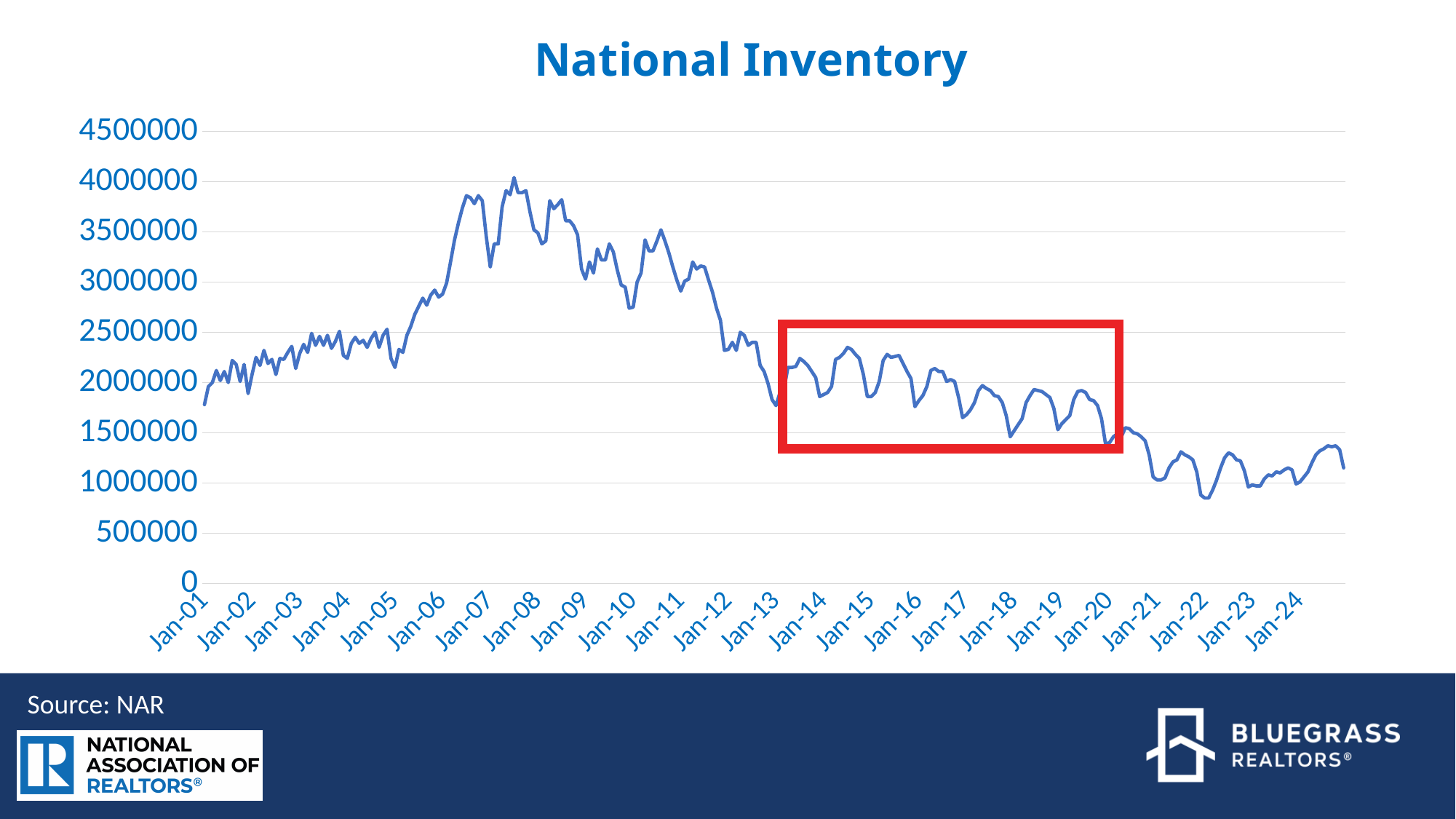
Is the value at Jan-08 larger or smaller than the value at Jan-24? larger What kind of chart is shown on the slide? line chart What source is cited for the chart? NAR How many year labels (Jan-01 through Jan-24) are shown on the x axis? 24 Does the line rise or fall between Jan-01 and Jan-07? rise Is the value at Jan-22 greater or less than 1000000? less Is the value at Jan-17 greater or less than 1500000? greater What is the title of the chart? National Inventory Is the value at Jan-01 greater or less than 2000000? less Does the line rise or fall between Jan-08 and Jan-13? fall